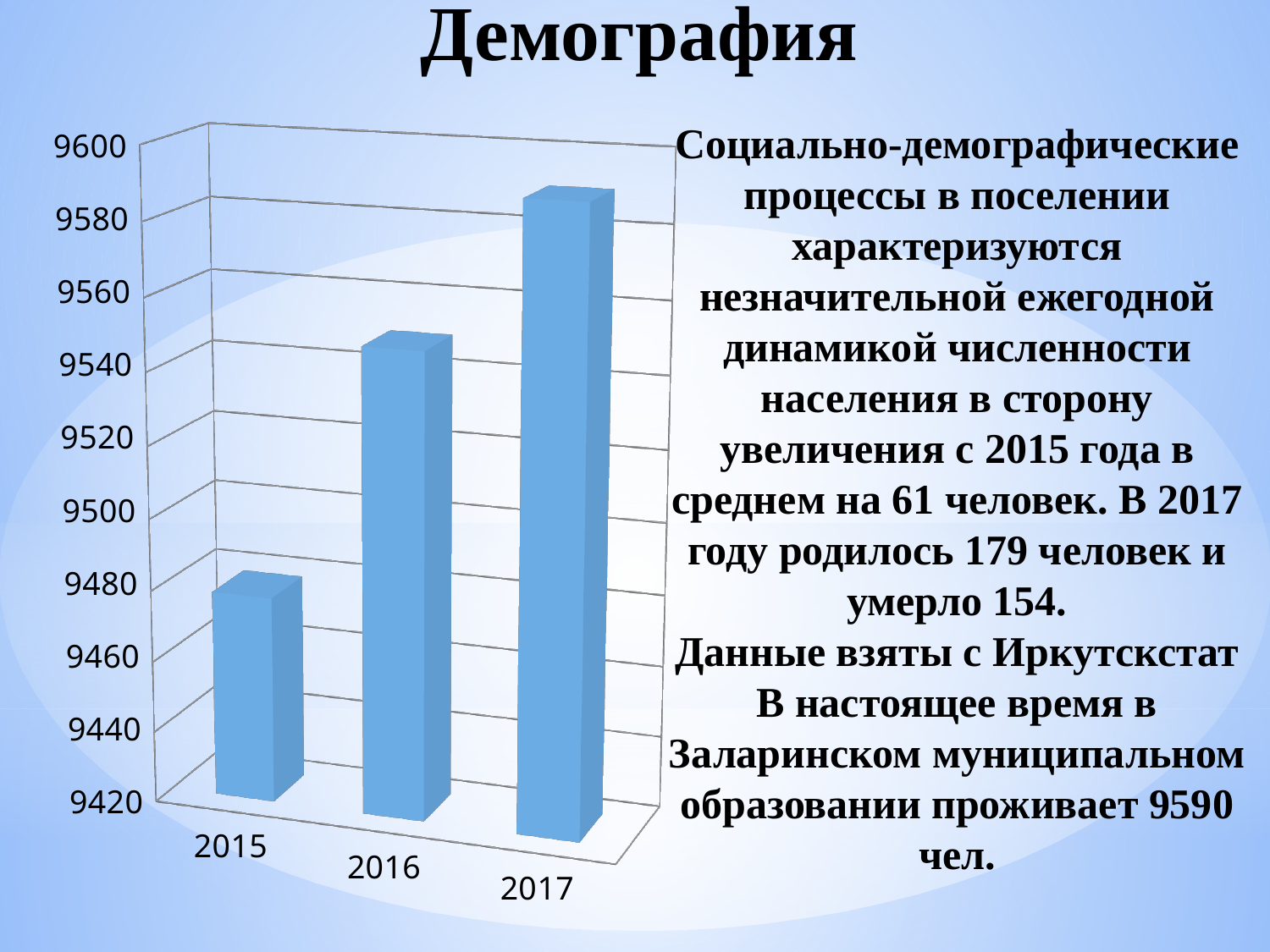
Is the value for 2016 greater or less than 9520? greater How many years (categories) are shown on the x axis of the chart? 3 Do the values rise or fall from 2015 to 2017? rise Is the value for 2016 greater or less than 9560? less Is the value for 2015 greater or less than 9500? less What is the lowest value shown on the vertical axis of the chart? 9420 Which year has the lowest bar in the chart? 2015 What kind of chart is shown on the slide? bar chart Which is larger, the value for 2016 or the value for 2015? 2016 Which year has the highest bar in the chart? 2017